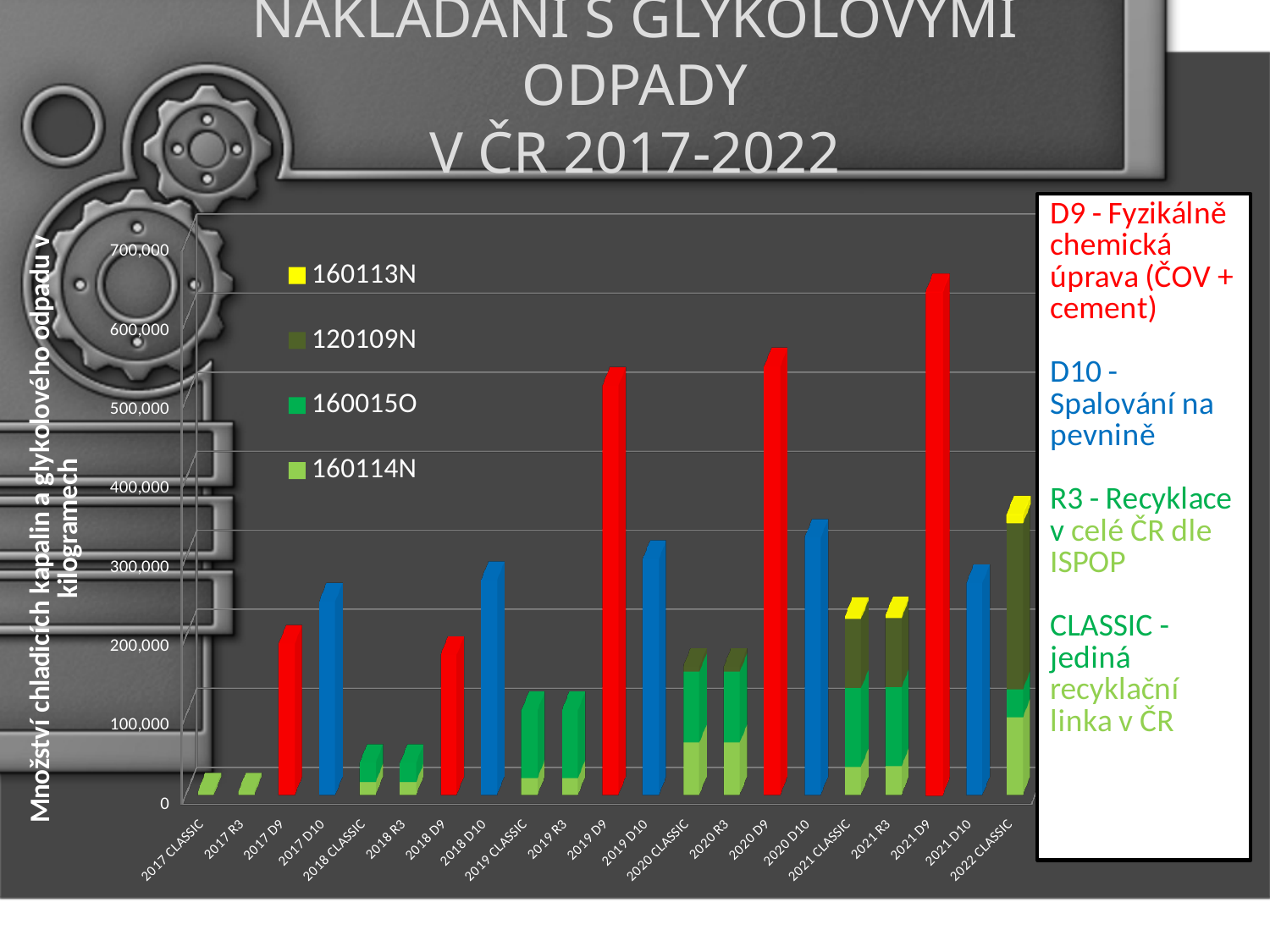
Which is larger, the bar for 2021 D9 or the bar for 2020 D9? 2021 D9 Which category has the tallest bar in the chart? 2021 D9 Is the value for 2017 CLASSIC greater or less than 100,000? less How many series does the chart legend list? 4 Do the D9 bars rise or fall from 2017 to 2021? rise Is the value for 2017 D10 greater or less than 200,000? greater What kind of chart is shown on the slide? bar chart Is the value for 2020 D9 greater or less than 500,000? greater Which is larger, the bar for 2019 D9 or the bar for 2019 D10? 2019 D9 Which colour represents the series 160113N in the legend? yellow How many categories are shown along the x axis of the chart? 21